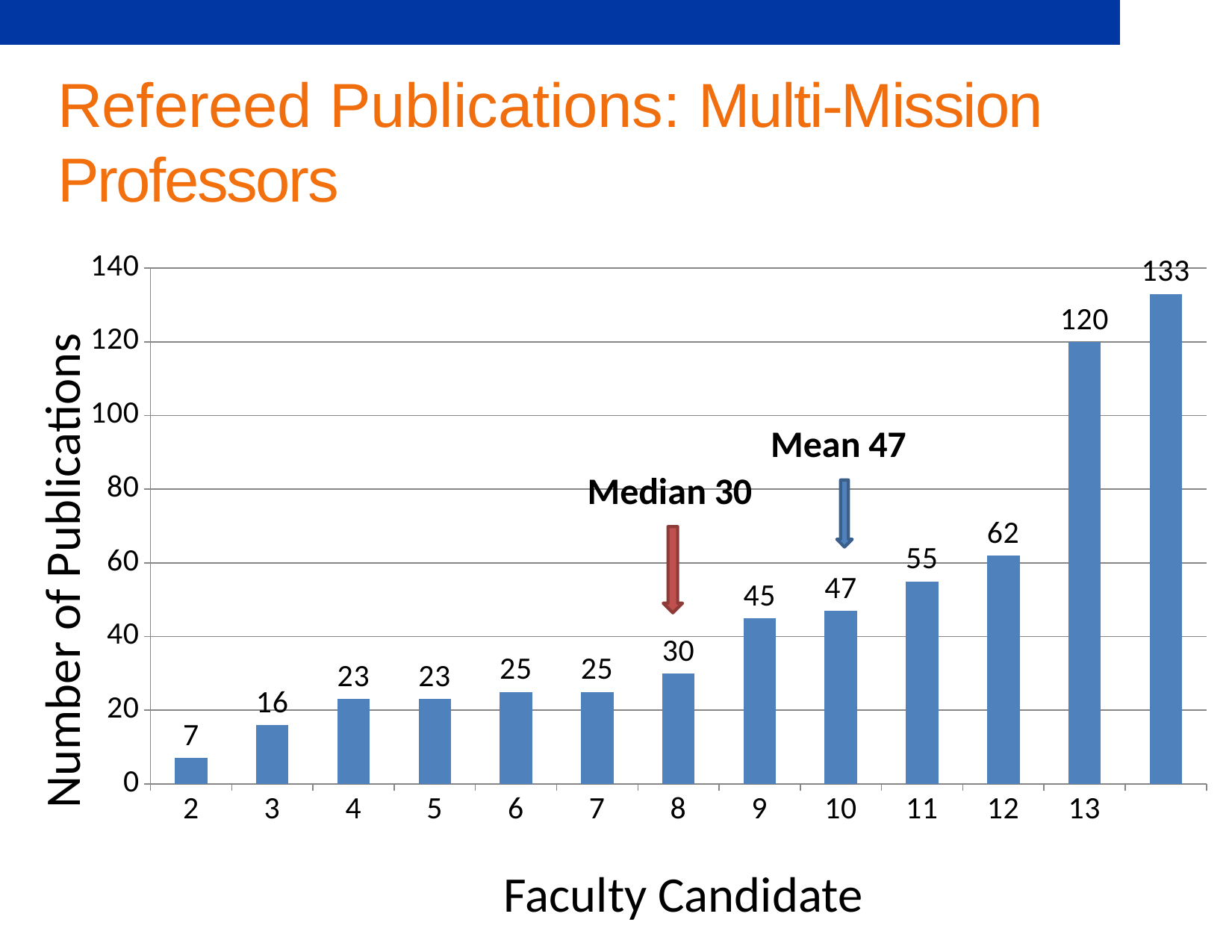
What is the label of the y axis? Number of Publications What type of chart is shown on the slide? bar chart How many bars are plotted on the chart? 13 What is the number of publications for faculty candidate 2? 7 Which faculty candidate has the lowest number of publications? 2 What is the highest number of publications shown on the chart? 133 What is the difference in publications between faculty candidate 13 and faculty candidate 12? 58 Do the values generally rise or fall from left to right along the x axis? rise Which has more publications, faculty candidate 9 or faculty candidate 11? Faculty candidate 11 How many publications does faculty candidate 8 have? 30 What mean value is annotated on the chart? Mean 47 What is the number of publications for faculty candidate 13? 120